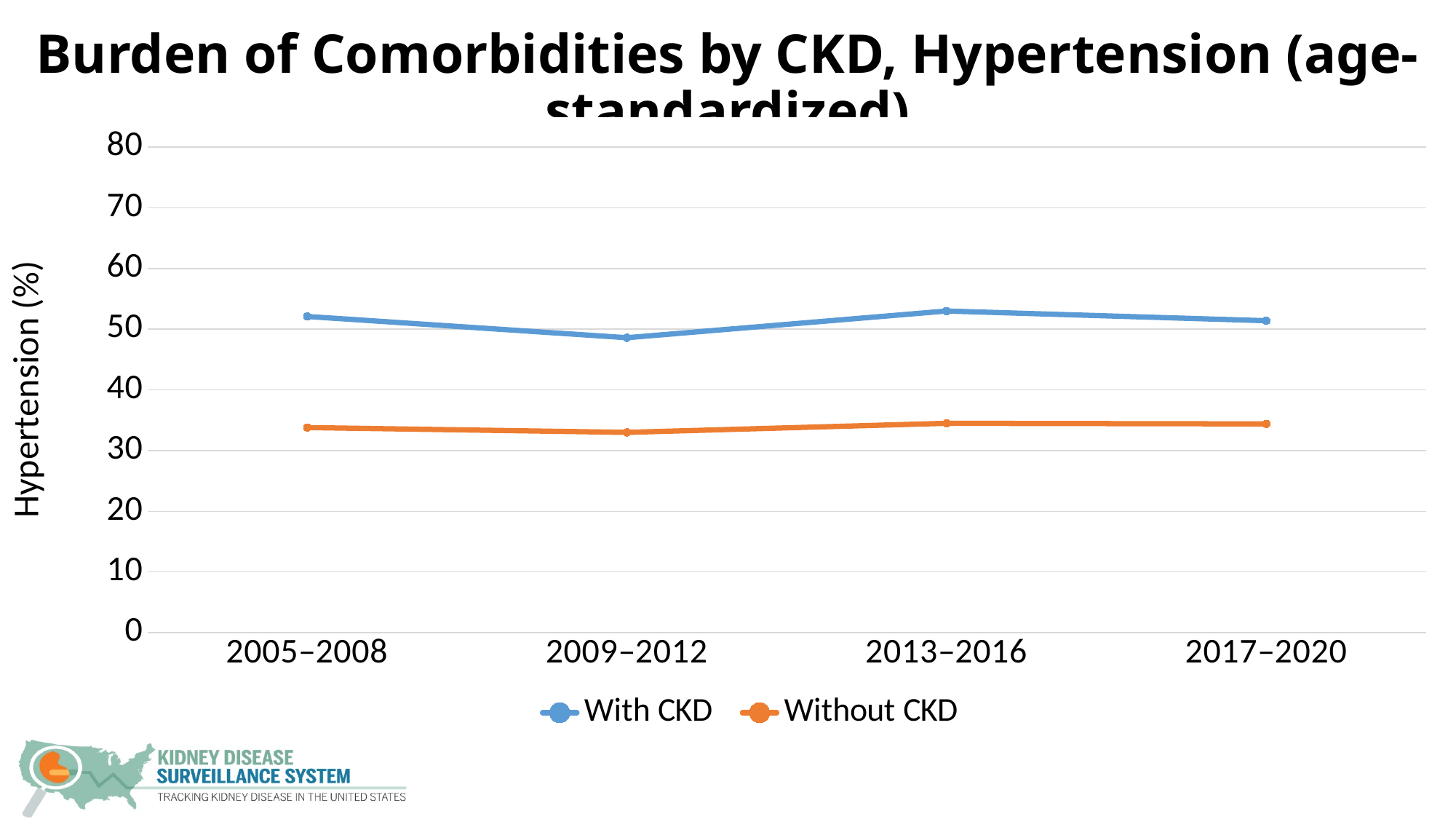
Is the value for With CKD in 2013–2016 greater or less than 50? greater Is the value for Without CKD in 2013–2016 greater or less than 30? greater How many series does the legend list? 2 What is the label on the y axis? Hypertension (%) Is the value for Without CKD in 2005–2008 greater or less than 40? less Does the With CKD series rise or fall from 2009–2012 to 2013–2016? rise What kind of chart is shown on the slide? line chart How many time periods are shown on the x axis? 4 Which series has the higher hypertension percentage in 2017–2020, With CKD or Without CKD? With CKD Which colour is used for the Without CKD series? orange In which period is the With CKD series at its lowest? 2009–2012